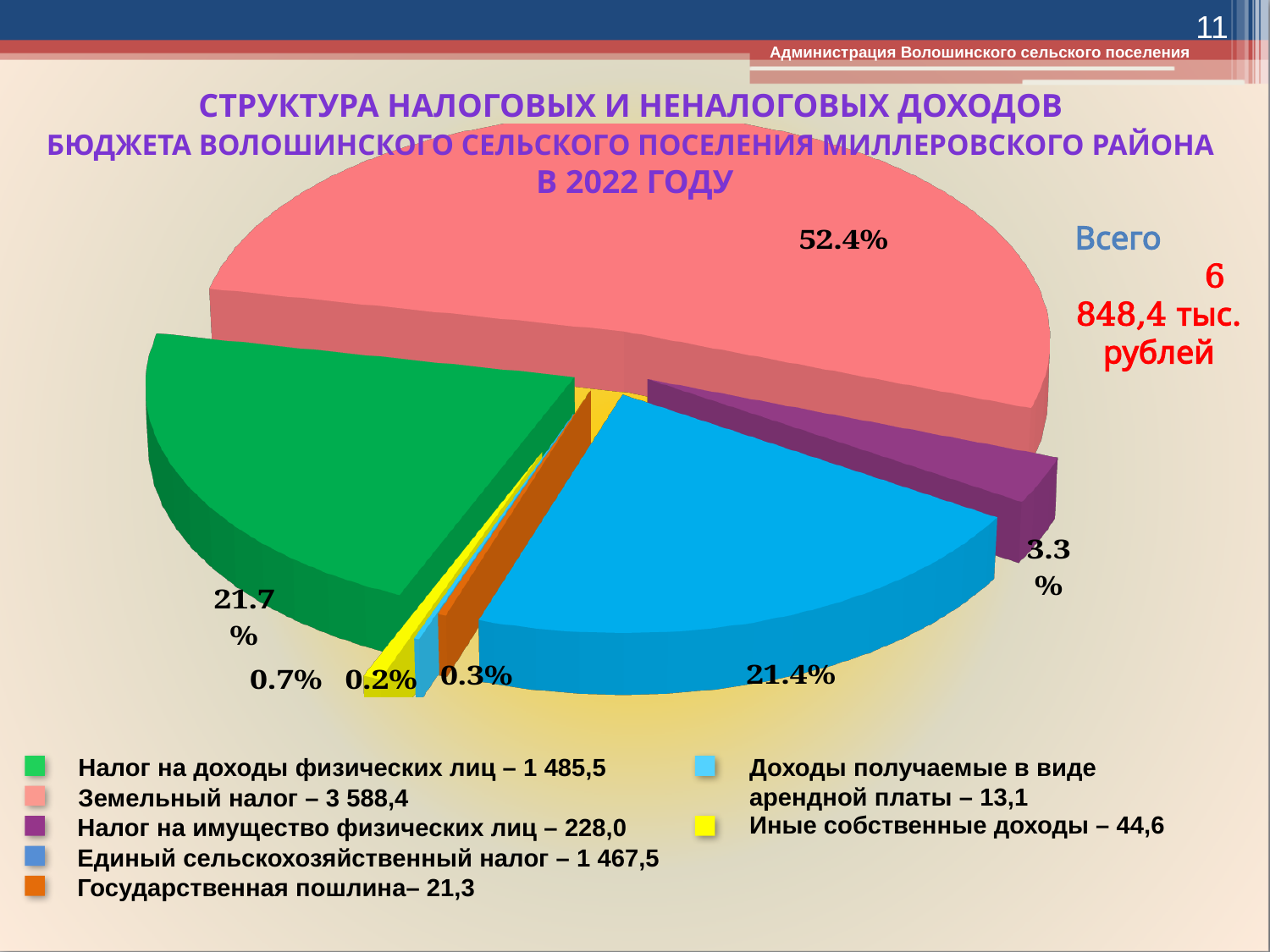
Which is larger: Налог на доходы физических лиц or Единый сельскохозяйственный налог? Налог на доходы физических лиц What is the value shown in the legend for Налог на доходы физических лиц? 1 485,5 What kind of chart is shown on the slide? pie chart What is the total of all revenues shown on the slide (Всего)? 6 848,4 тыс. рублей What share of the pie does Единый сельскохозяйственный налог take? 21.4% What is the value shown in the legend for Государственная пошлина? 21,3 Which category has the largest share of the pie? Земельный налог What share of the pie does Налог на имущество физических лиц take? 3.3% What colour is the slice for Иные собственные доходы? yellow Which category has the smallest share of the pie? Доходы получаемые в виде арендной платы How many slices does the pie chart have? 7 What share of the pie does Земельный налог (land tax) take? 52.4%